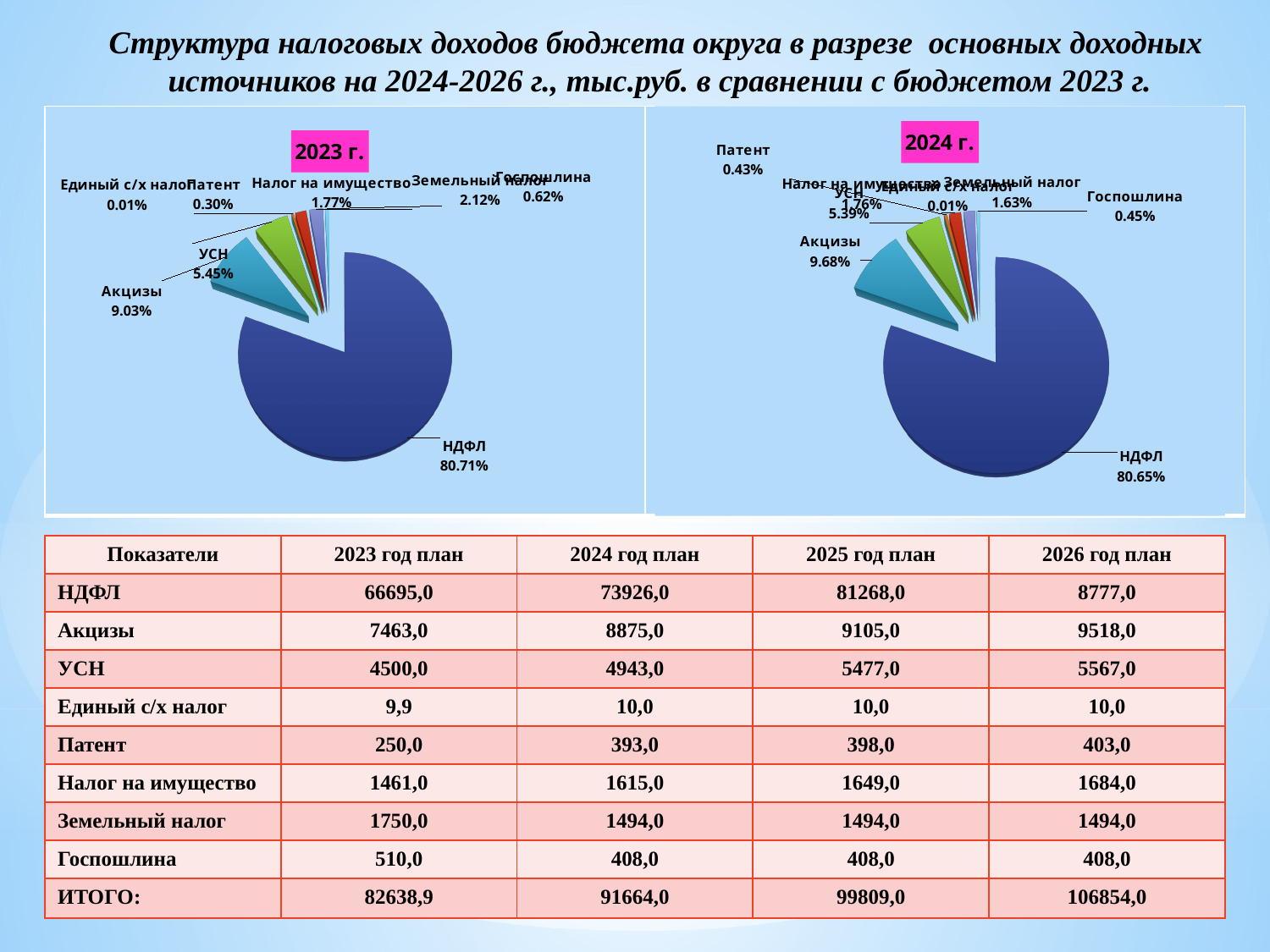
In the 2023 г. chart, what is the value for УСН? 5.45% In the 2023 г. chart, which category has the smallest share? Единый с/х налог In the 2024 г. chart, what is the value for Госпошлина? 0.45% In the 2023 г. chart, which is larger: Земельный налог or Госпошлина? Земельный налог In the 2023 г. chart, what is the difference between the shares of Акцизы and УСН? 3.58% In the 2023 г. chart, what is the value for Акцизы? 9.03% In the 2024 г. chart, what is the value for Акцизы? 9.68% How many slices does the 2023 г. pie chart have? 8 What kind of chart is the 2023 г. chart? pie chart In the 2023 г. chart, which category has the largest share? НДФЛ In the 2024 г. chart, what share does НДФЛ have? 80.65% In the 2023 г. chart, what share does НДФЛ have? 80.71%